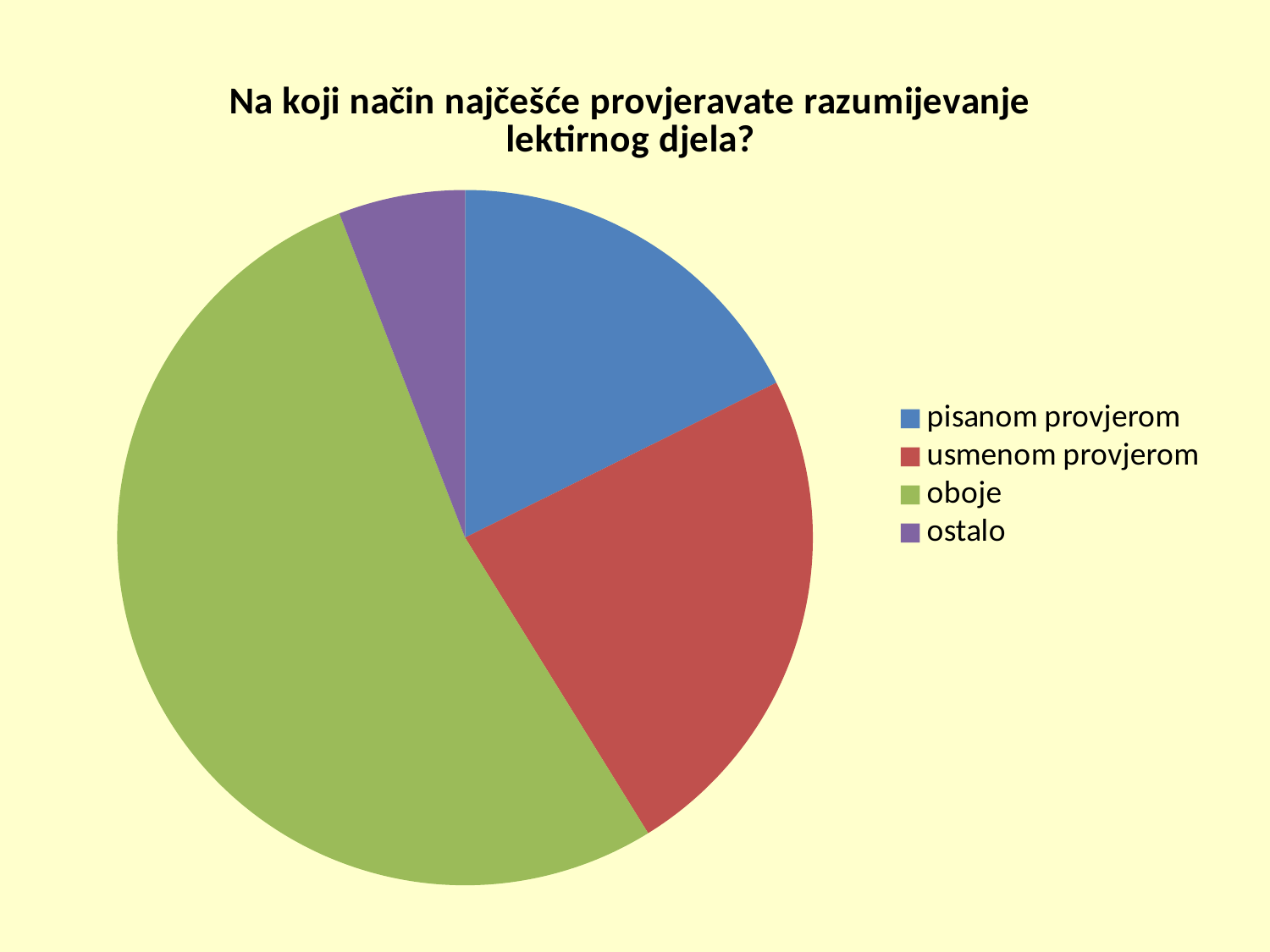
What is the title of the chart? Na koji način najčešće provjeravate razumijevanje lektirnog djela? Which slice is larger, usmenom provjerom or ostalo? usmenom provjerom Which slice is larger, usmenom provjerom or pisanom provjerom? usmenom provjerom How many entries does the legend list? 4 Which slice is larger, oboje or usmenom provjerom? oboje How many slices does the pie chart have? 4 Which category has the smallest slice of the pie? ostalo What kind of chart is shown on the slide? pie chart Which category has the largest slice of the pie? oboje What colour is the slice for oboje? green